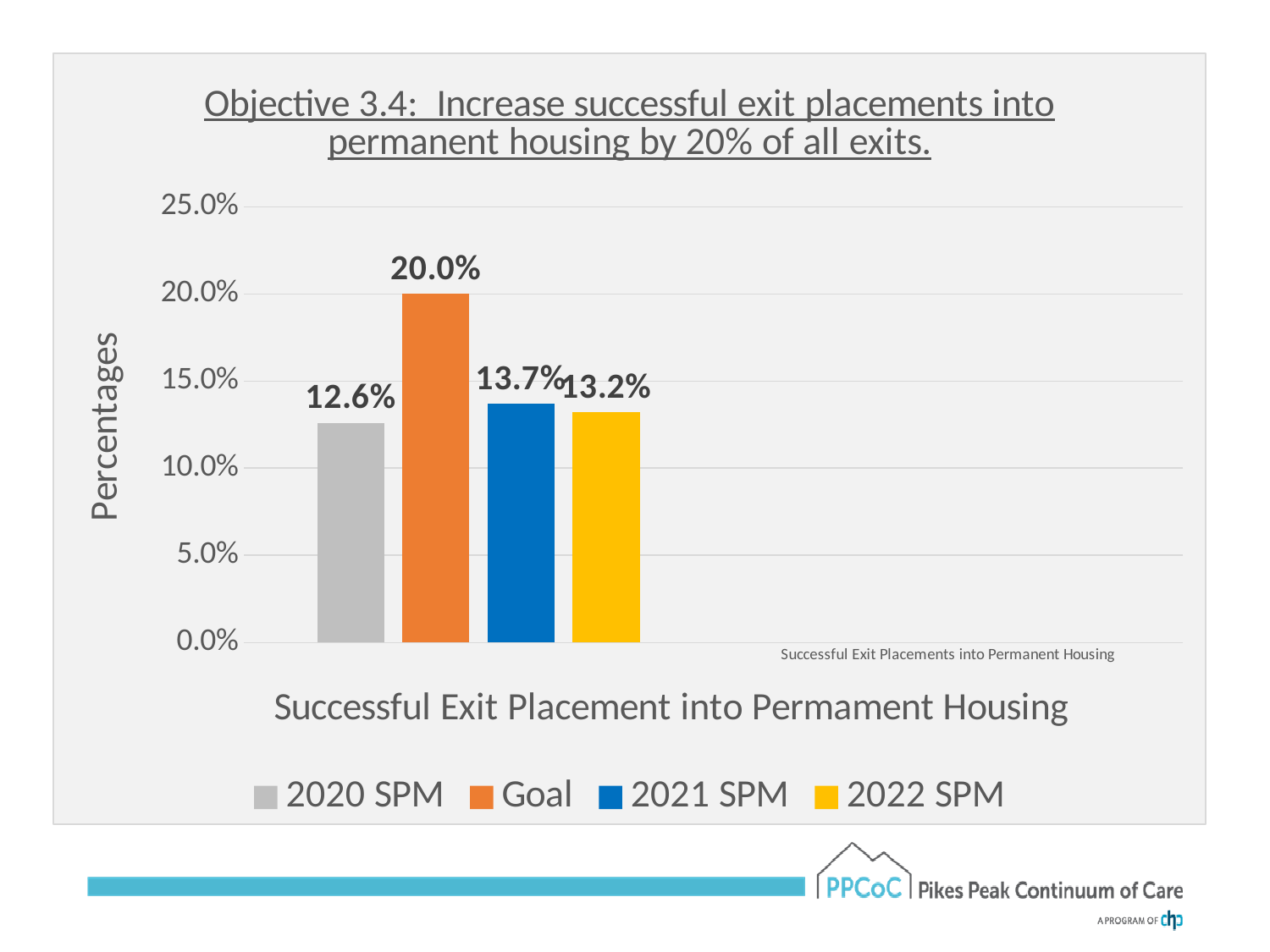
What is the label on the vertical axis of the chart? Percentages What is the value for the Goal series? 20.0% What is the difference between the Goal value and the 2022 SPM value? 6.8% Which series has the lowest value? 2020 SPM What is the difference between the 2021 SPM value and the 2020 SPM value? 1.1% How many series does the legend list? 4 Which series has the highest value? Goal Which is larger, the value for 2021 SPM or the value for 2022 SPM? 2021 SPM What is the value for 2022 SPM? 13.2% What is the value for 2020 SPM? 12.6% What kind of chart is shown on the slide? Bar chart What is the value for 2021 SPM? 13.7%